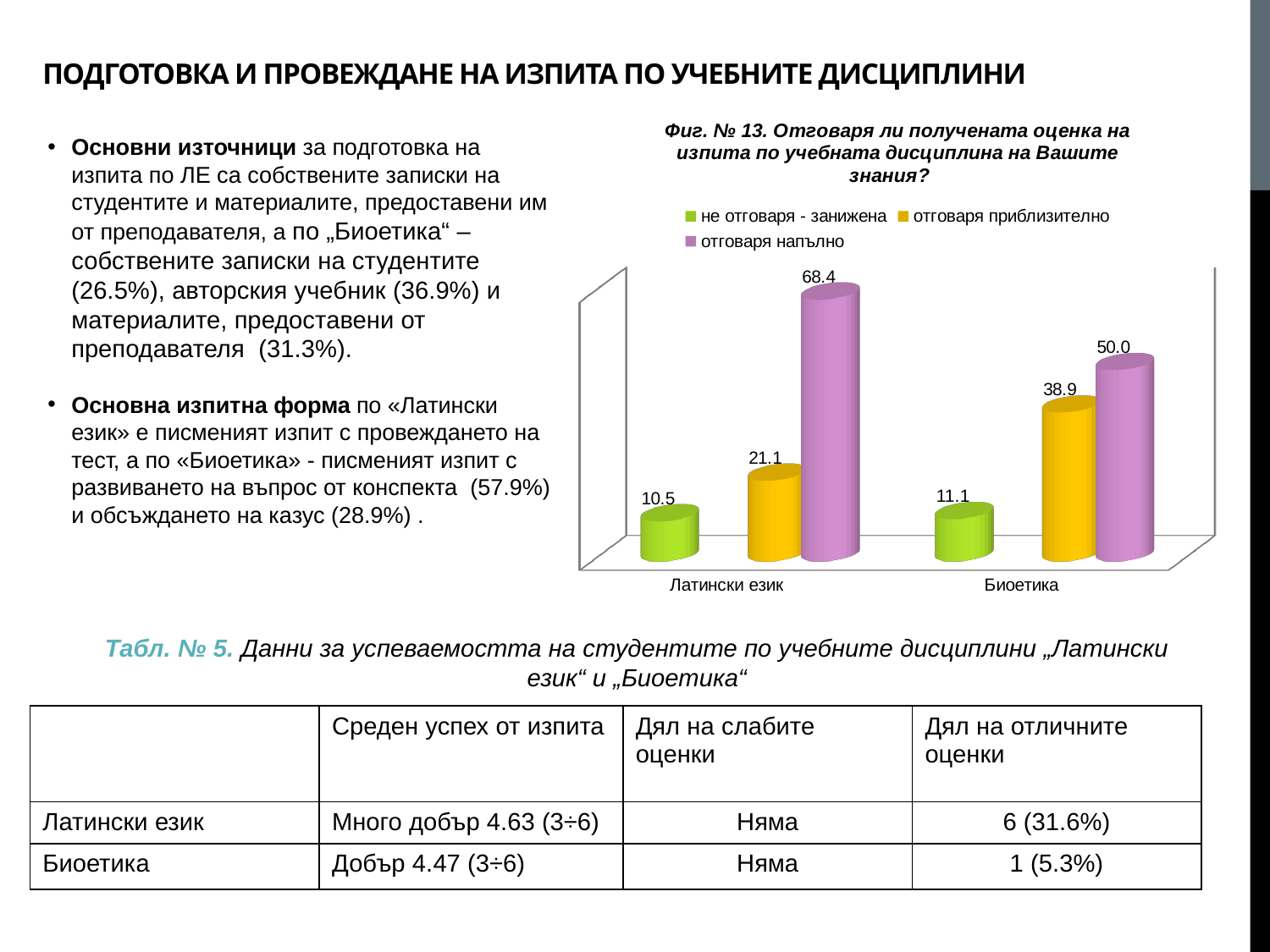
What is the value for "не отговаря - занижена" for Латински език? 10.5 What is the difference between the "отговаря напълно" values for Латински език and Биоетика? 18.4 What is the value for "отговаря приблизително" for Биоетика? 38.9 Which is larger: "отговаря приблизително" for Латински език or for Биоетика? Биоетика Which series has the lowest value for Биоетика? не отговаря - занижена How many series does the chart legend list? 3 What is the figure number of the chart on the slide? Фиг. № 13 What is the value for "отговаря напълно" for Биоетика? 50.0 How many categories are shown on the x axis of the chart? 2 What kind of chart is shown on the slide? Bar chart Which series has the highest value for Латински език? отговаря напълно What is the value for "отговаря напълно" for Латински език? 68.4